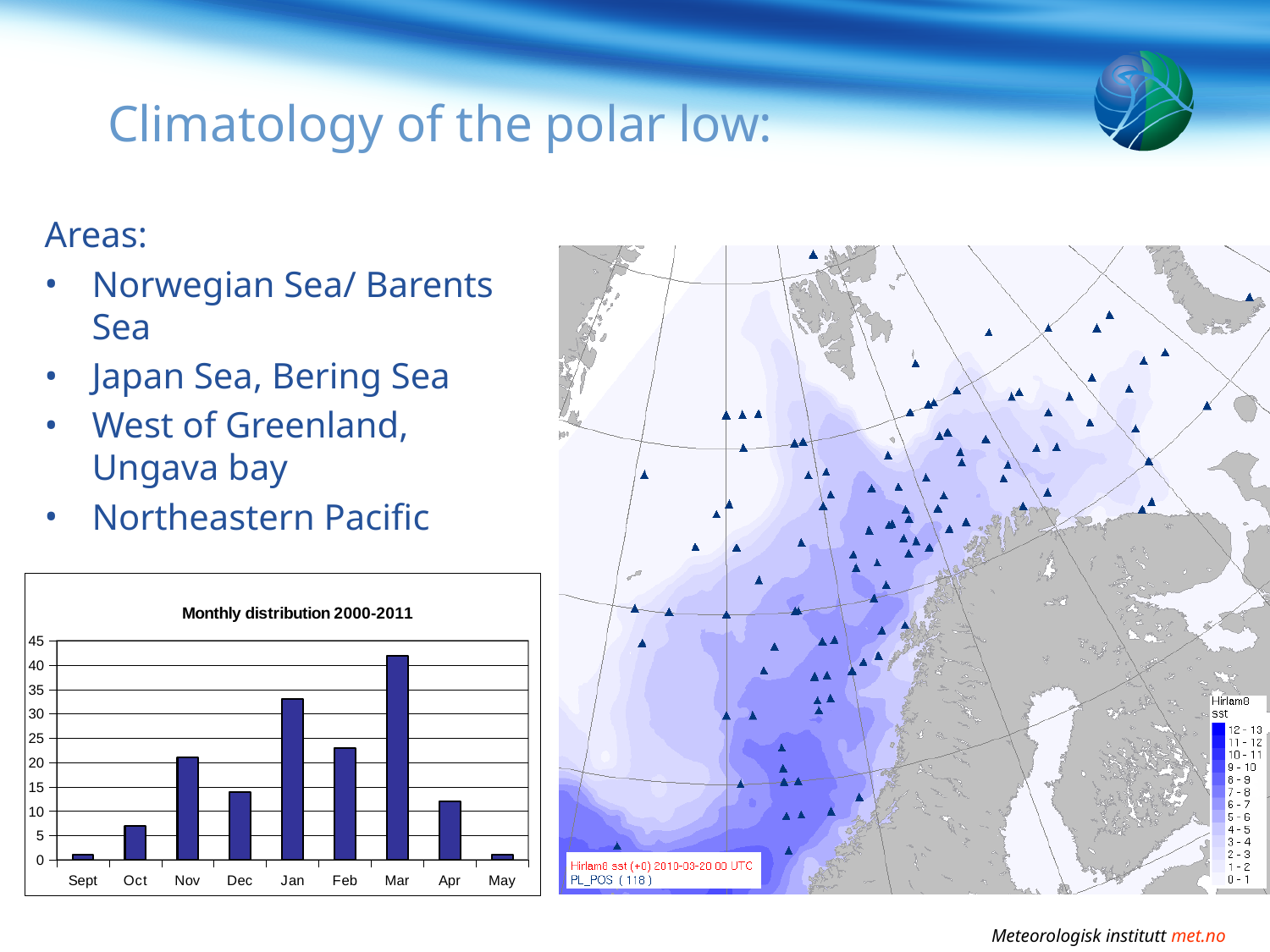
What kind of chart is the 'Monthly distribution 2000-2011' chart? bar chart In the 'Monthly distribution 2000-2011' chart, is the value for Jan greater or less than 30? greater How many months are shown on the x axis of the 'Monthly distribution 2000-2011' chart? 9 In the 'Monthly distribution 2000-2011' chart, which is larger, the value for Nov or the value for Dec? Nov In the 'Monthly distribution 2000-2011' chart, is the value for Mar greater or less than 40? greater In the 'Monthly distribution 2000-2011' chart, is the value for Oct greater or less than 10? less In the 'Monthly distribution 2000-2011' chart, do the values rise or fall from Mar to May? fall What is the title of the chart on the slide? Monthly distribution 2000-2011 Which month has the highest value in the 'Monthly distribution 2000-2011' chart? Mar In the 'Monthly distribution 2000-2011' chart, which is larger, the value for Jan or the value for Feb? Jan